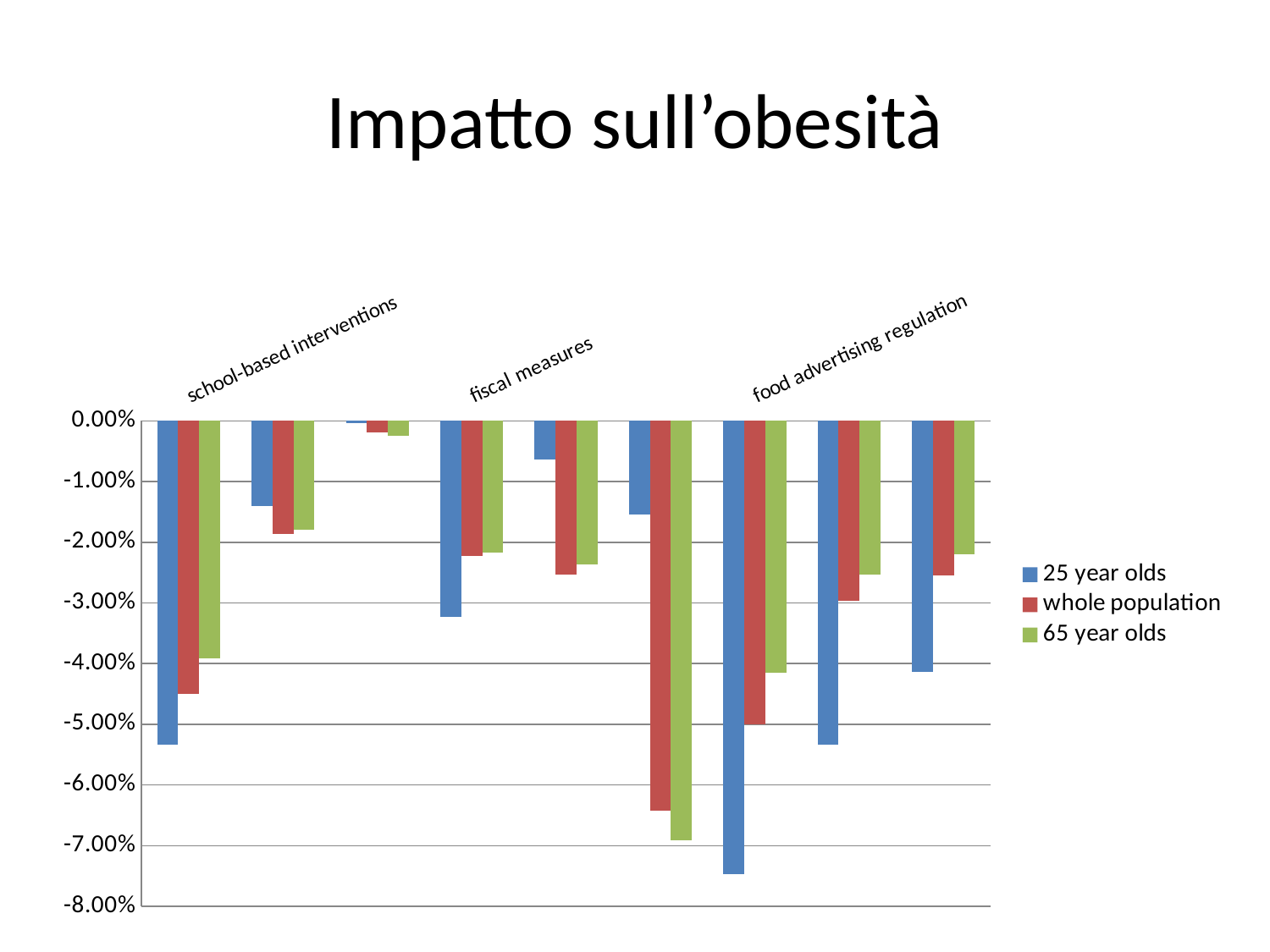
Among 'school-based interventions', 'fiscal measures' and 'food advertising regulation', which has the lowest (most negative) value for 25 year olds? food advertising regulation What kind of chart is shown on the slide? bar chart Is the value for 25 year olds under 'food advertising regulation' greater or less than -7.00%? less Is the value for 25 year olds under 'fiscal measures' greater or less than -3.00%? less Which colour represents the 'whole population' series in the legend? red Under 'school-based interventions', which is lower (more negative): the value for 25 year olds or for 65 year olds? 25 year olds Is the value for 65 year olds under 'school-based interventions' greater or less than -3.00%? less What is the title of the slide? Impatto sull'obesità How many series does the legend list? 3